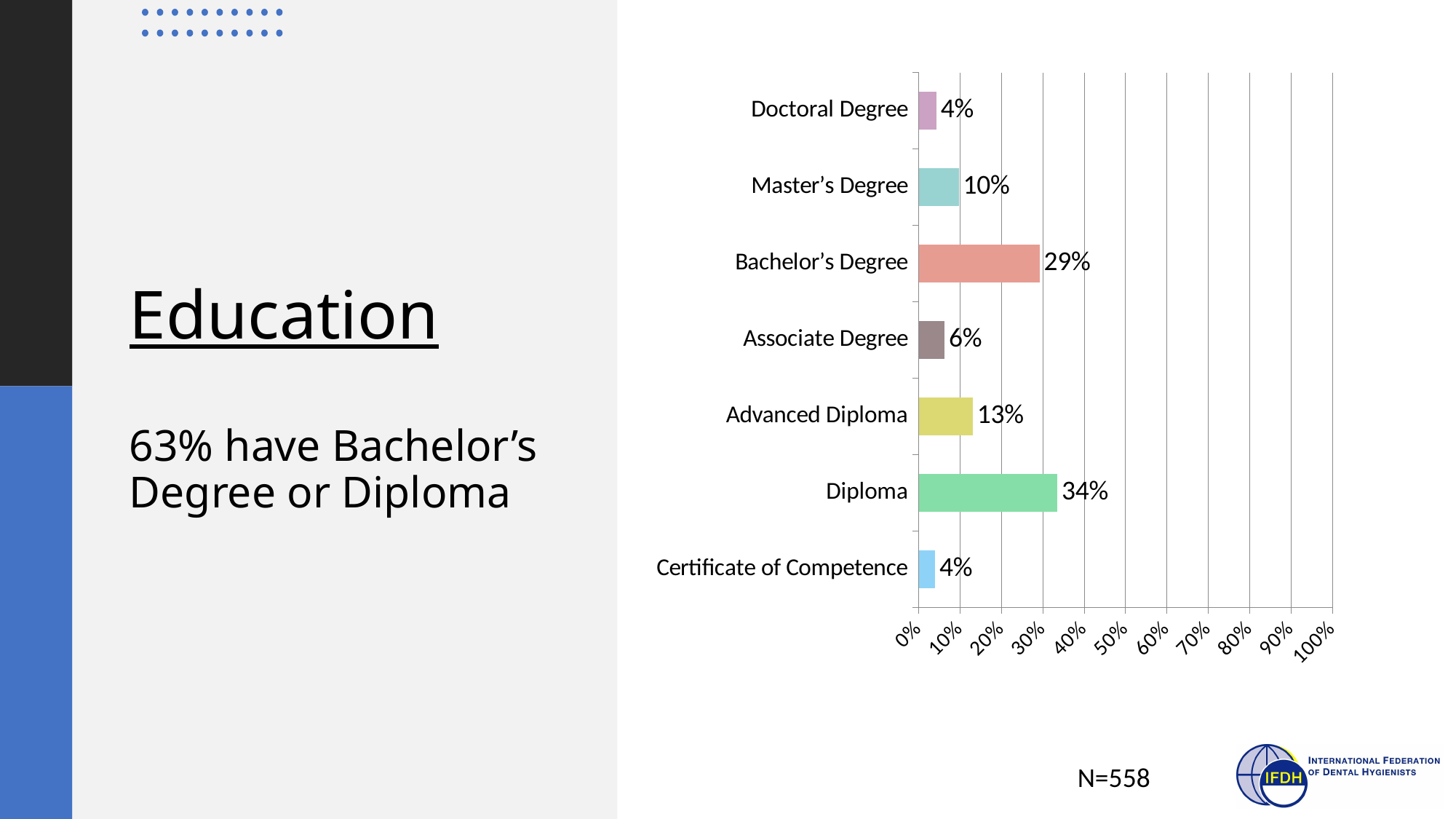
What is the difference between the Diploma and Bachelor's Degree percentages? 5% What is the value for Advanced Diploma? 13% What sample size (N) is stated on the slide? N=558 What is the value shown for Diploma? 34% Is the value for Bachelor's Degree greater or less than 20%? greater Which education category has the highest percentage? Diploma What percentage have a Master's Degree? 10% Which category has the lowest value, Associate Degree or Master's Degree? Associate Degree What percentage of respondents have a Bachelor's Degree? 29% How many education categories are shown in the chart? 7 What kind of chart is shown on the slide? Bar chart Which is larger, Advanced Diploma or Master's Degree? Advanced Diploma